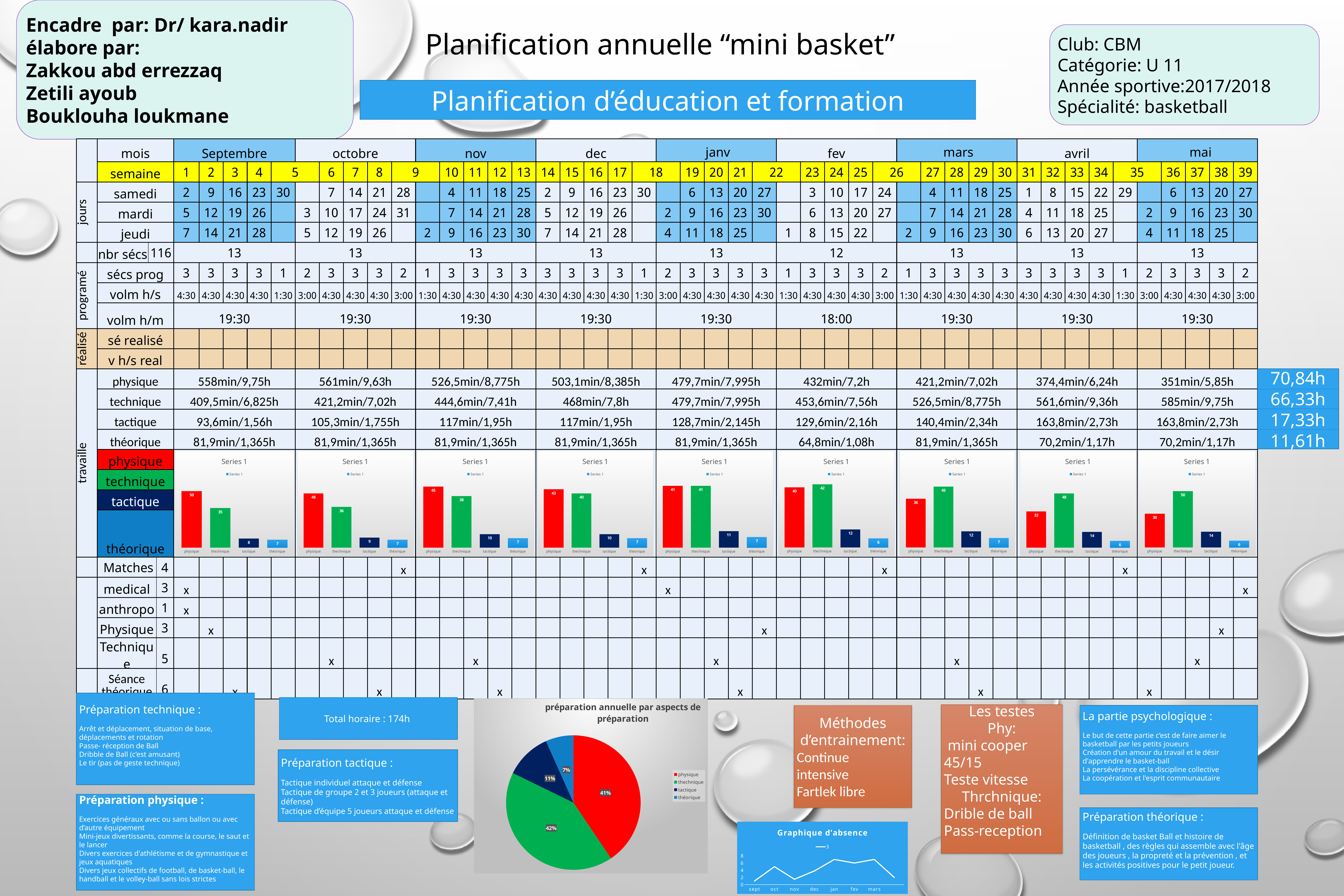
In the Avril bar chart, which category has the highest value? technique In 'Graphique d'absence', is the value for jan greater or less than 4? greater In the Octobre bar chart, what is the difference between physique and technique? 12 In the Fev bar chart, which is larger, physique or technique? technique In the Septembre bar chart, which category has the lowest value? théorique In the Septembre bar chart, what is the value for physique? 50 In the Mars bar chart, how many categories are plotted? 4 In the pie chart 'préparation annuelle par aspects de préparation', how many entries does the legend list? 4 In the pie chart 'préparation annuelle par aspects de préparation', which slice is the smallest? théorique In the Mai bar chart, what is the value for technique? 50 In the pie chart 'préparation annuelle par aspects de préparation', what share does technique have? 42% What kind of chart is 'Graphique d'absence'? line chart